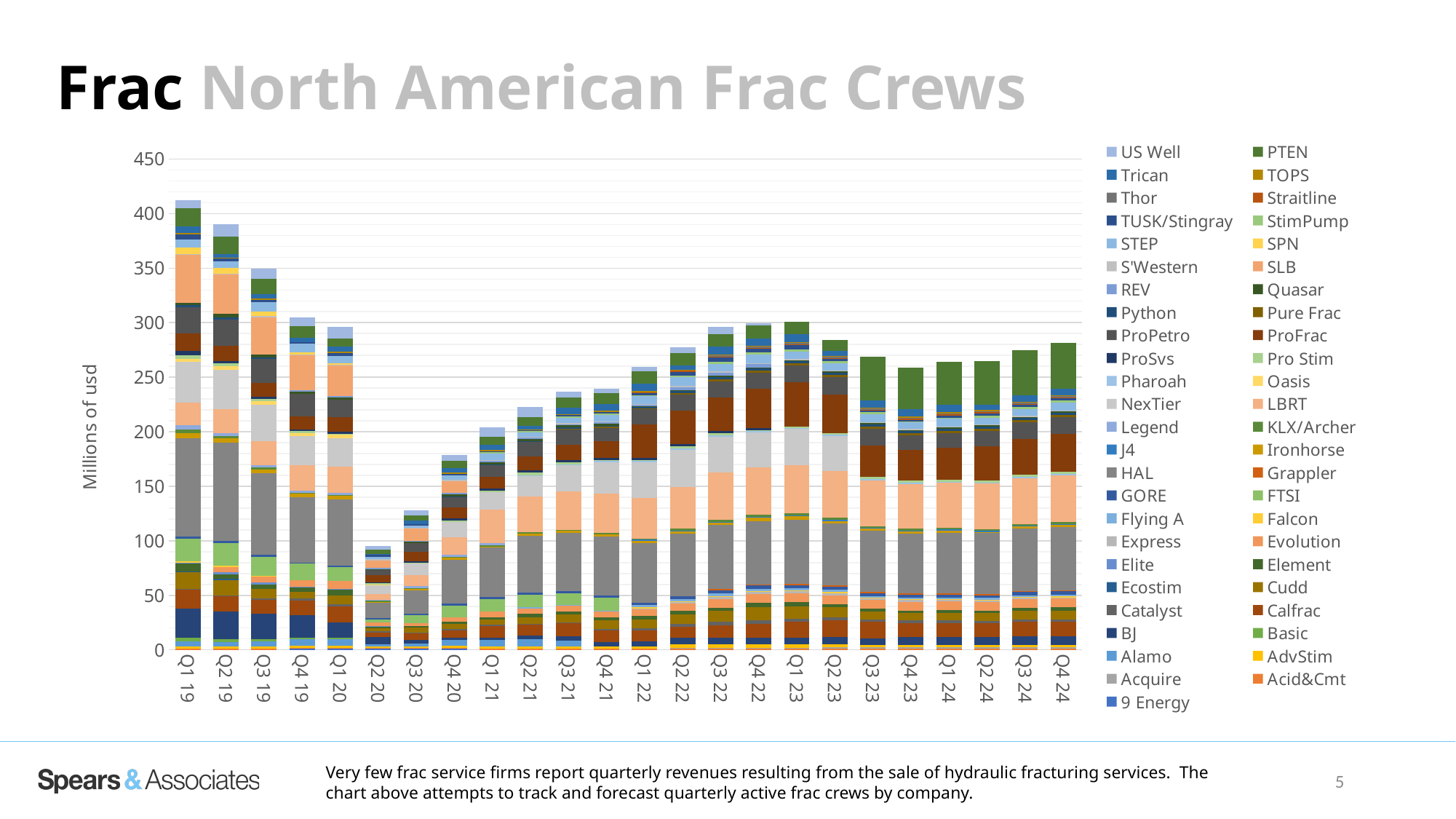
Is the total for Q2 22 greater or less than 300? less Is the total for Q4 24 greater or less than 250? greater Is the total for Q1 19 greater or less than 400? greater How many quarters are shown on the x axis? 24 Which has the larger total, Q2 20 or Q3 20? Q3 20 Do the bar totals rise or fall from Q1 19 to Q2 20? Fall Which quarter has the lowest total stacked bar? Q2 20 Which quarter has the highest total stacked bar? Q1 19 Which has the larger total, Q1 19 or Q4 24? Q1 19 What kind of chart is shown on the slide? Stacked bar chart What is the label on the vertical axis? Millions of usd